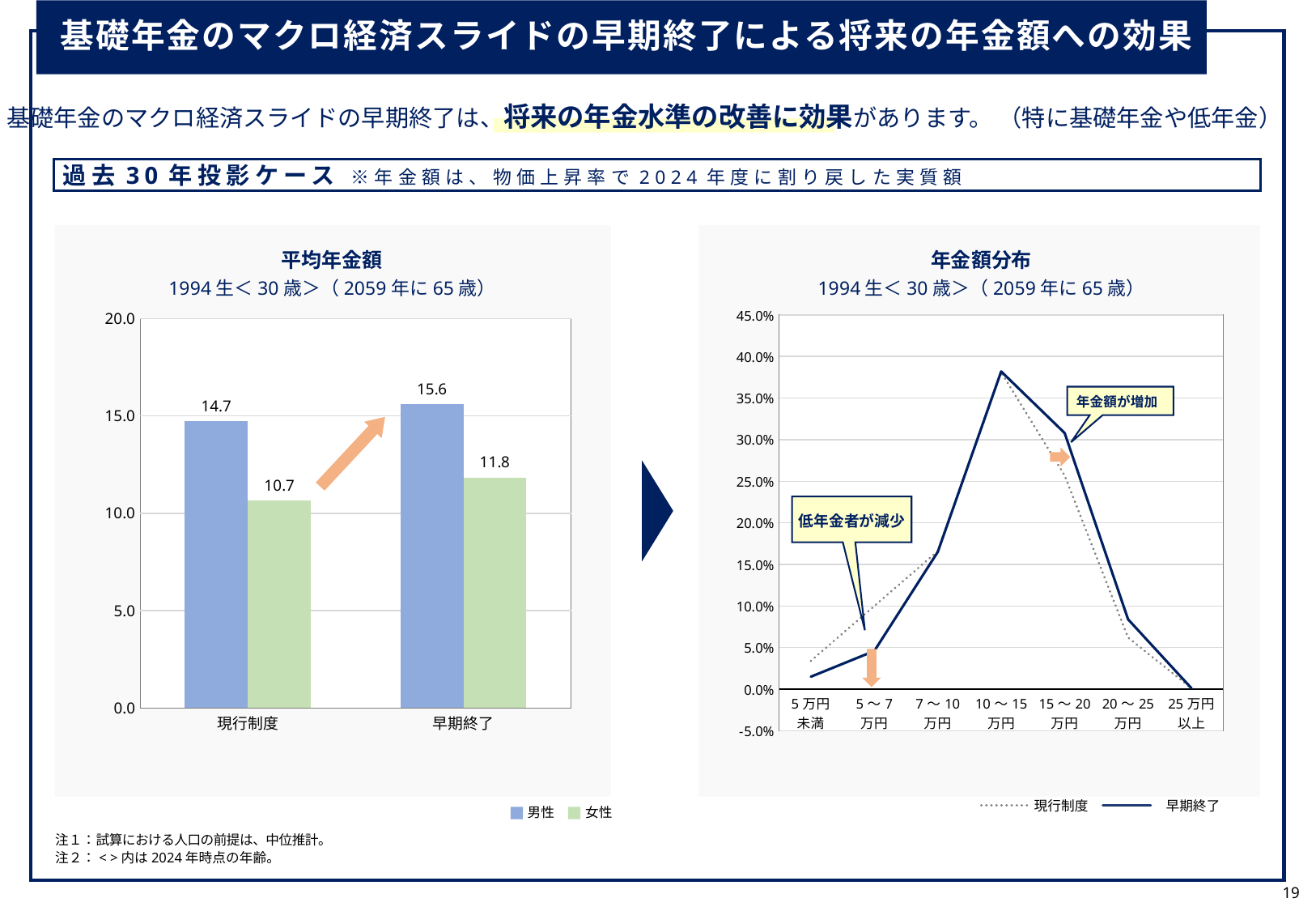
In the 平均年金額 chart, which bar has the highest value? 男性 under 早期終了 In the 平均年金額 chart, what is the value for 女性 under 現行制度? 10.7 In the 平均年金額 chart, what is the value for 女性 under 早期終了? 11.8 In the 年金額分布 chart, which category has the highest value for the 早期終了 series? 10～15万円 In the 平均年金額 chart, what is the difference between 男性 and 女性 under 早期終了? 3.8 In the 平均年金額 chart, what is the difference between the 男性 values for 早期終了 and 現行制度? 0.9 What kind of chart is the 平均年金額 chart? bar chart In the 平均年金額 chart, what is the value for 男性 under 現行制度? 14.7 How many categories are shown on the x axis of the 年金額分布 chart? 7 In the 年金額分布 chart, is the 早期終了 value for 10～15万円 greater or less than 35.0%? greater How many series does the legend of the 年金額分布 chart list? 2 In the 平均年金額 chart, which is larger: 女性 under 現行制度 or 女性 under 早期終了? 女性 under 早期終了